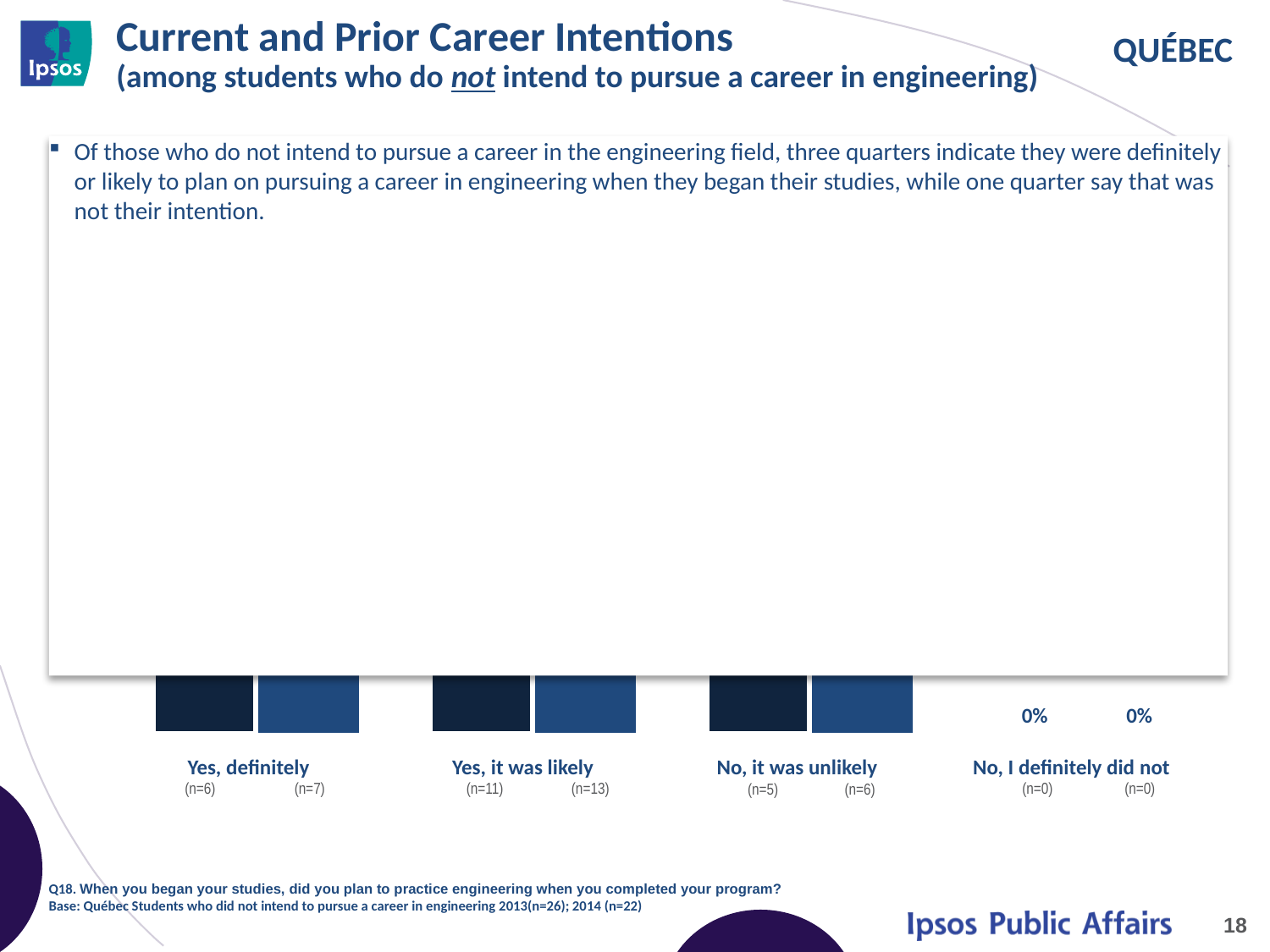
Which is larger in the chart: the value for 'No, it was unlikely' or the value for 'No, I definitely did not'? No, it was unlikely How many categories are shown along the x axis of the chart? 4 What value is labelled for the 'No, I definitely did not' category in the chart? 0% What is the first category label on the x axis of the chart? Yes, definitely What kind of chart is shown on the slide? bar chart Which is larger in the chart: the value for 'Yes, definitely' or the value for 'No, I definitely did not'? Yes, definitely How many bars are plotted for each category in the chart? 2 Which category has the lowest values in the chart? No, I definitely did not